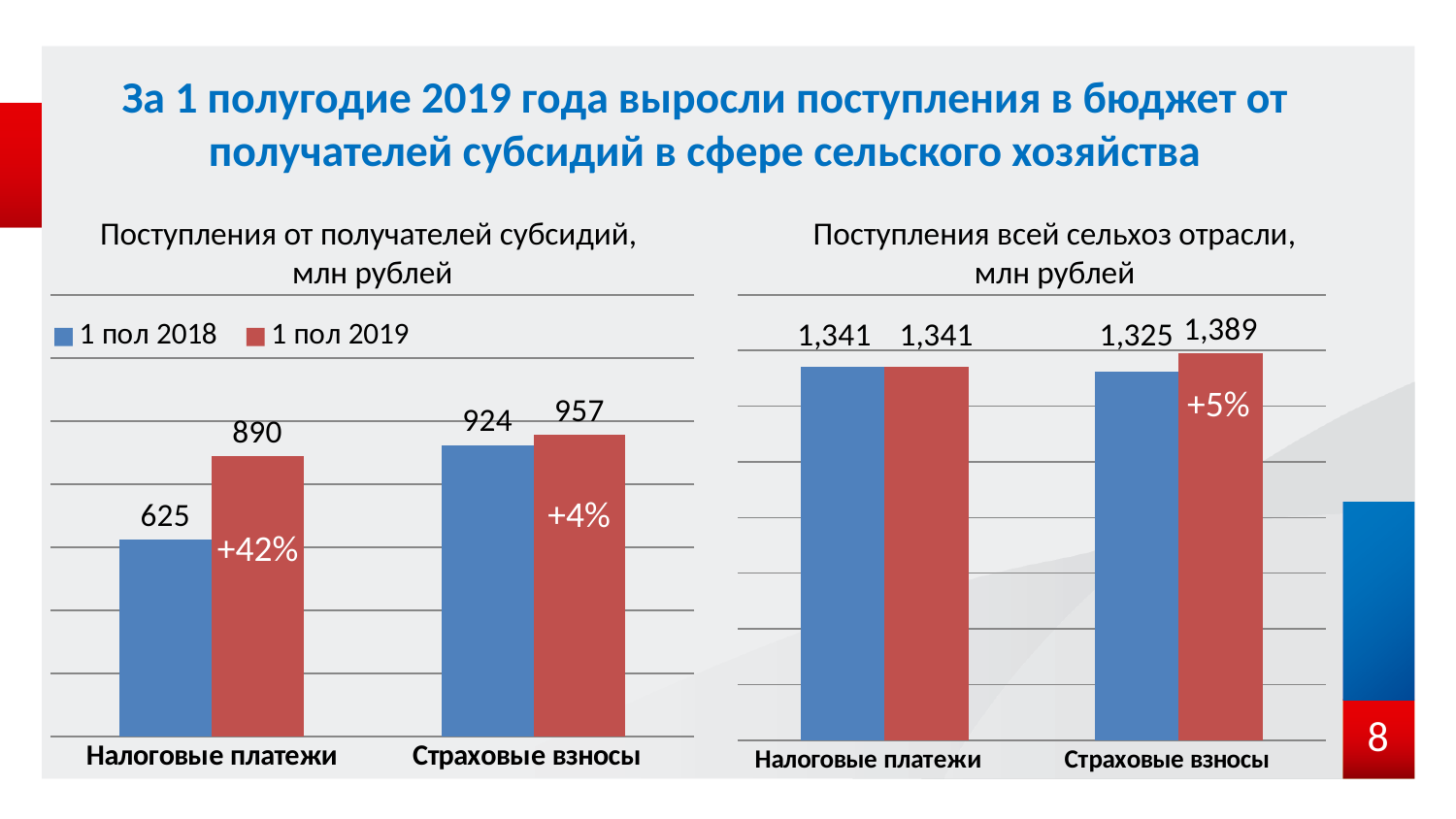
In the left chart (Поступления от получателей субсидий), what is the value for Налоговые платежи in 1 пол 2019? 890 In the right chart (Поступления всей сельхоз отрасли), what is the value for Налоговые платежи in 1 пол 2018? 1,341 How many categories are shown on the x axis of the right chart (Поступления всей сельхоз отрасли)? 2 In the left chart (Поступления от получателей субсидий), which category has the lowest value in 1 пол 2018? Налоговые платежи In the left chart (Поступления от получателей субсидий), what is the difference between the 1 пол 2019 and 1 пол 2018 values for Налоговые платежи? 265 In the left chart (Поступления от получателей субсидий), what is the value for Страховые взносы in 1 пол 2018? 924 What type of chart is the left chart (Поступления от получателей субсидий)? Bar chart How many series does the legend of the left chart (Поступления от получателей субсидий) list? 2 In the right chart (Поступления всей сельхоз отрасли), what is the value for Страховые взносы in 1 пол 2019? 1,389 In the right chart (Поступления всей сельхоз отрасли), what is the difference between the 1 пол 2019 and 1 пол 2018 values for Страховые взносы? 64 In the left chart (Поступления от получателей субсидий), which is larger for Страховые взносы: 1 пол 2018 or 1 пол 2019? 1 пол 2019 In the left chart (Поступления от получателей субсидий), what percentage change is labelled on the Налоговые платежи bar? +42%